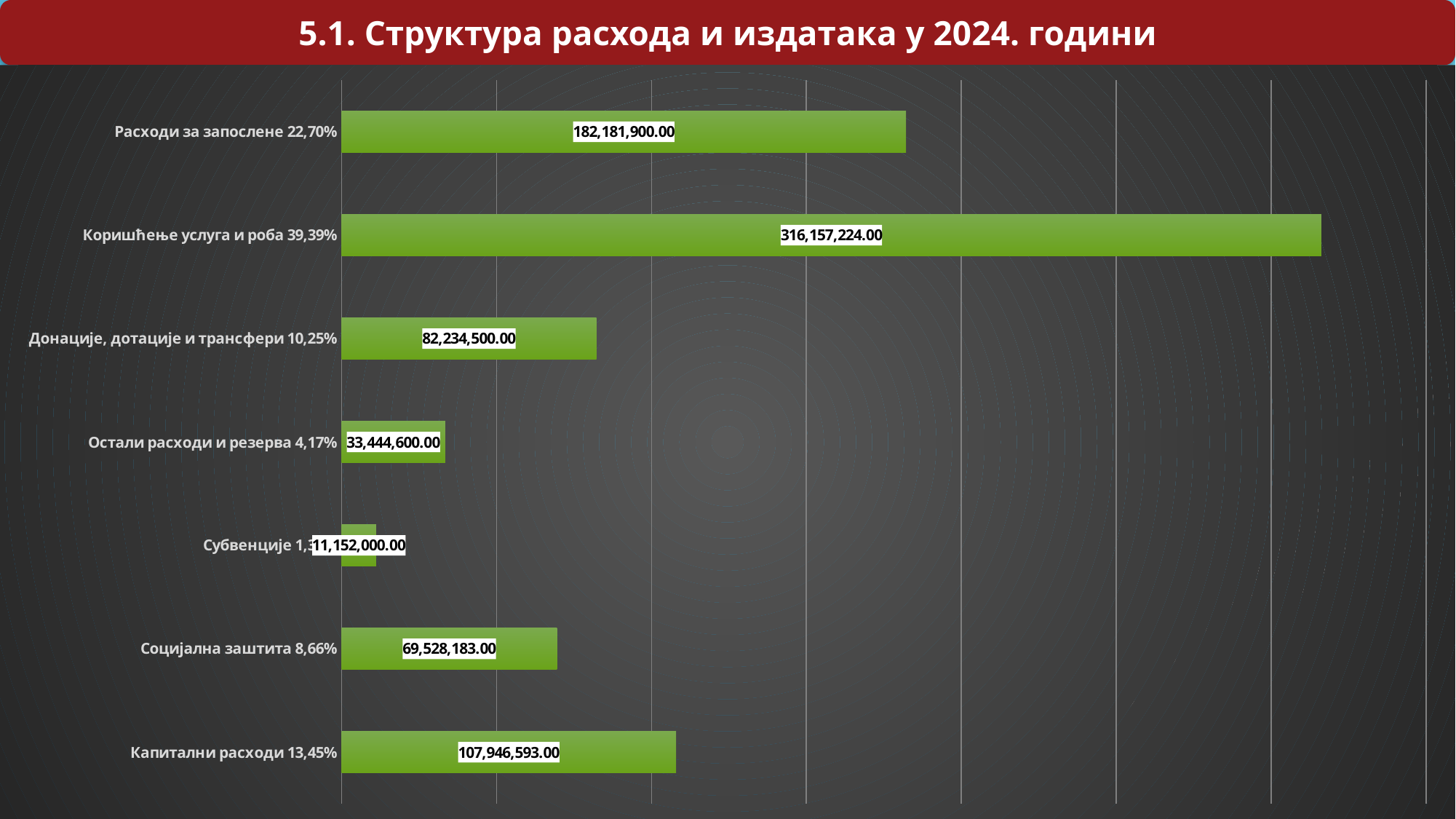
Which is larger, Капитални расходи or Социјална заштита? Капитални расходи What is the value for Субвенције? 11,152,000.00 What is the difference between Донације, дотације и трансфери and Социјална заштита? 12,706,317.00 What is the value for Донације, дотације и трансфери? 82,234,500.00 What is the difference between Коришћење услуга и роба and Расходи за запослене? 133,975,324.00 How many categories are shown in the chart? 7 What kind of chart is shown on the slide? Bar chart What is the value for Расходи за запослене? 182,181,900.00 What is the value for Капитални расходи? 107,946,593.00 What is the value for Коришћење услуга и роба? 316,157,224.00 Which category has the lowest value? Субвенције Which category has the highest value? Коришћење услуга и роба